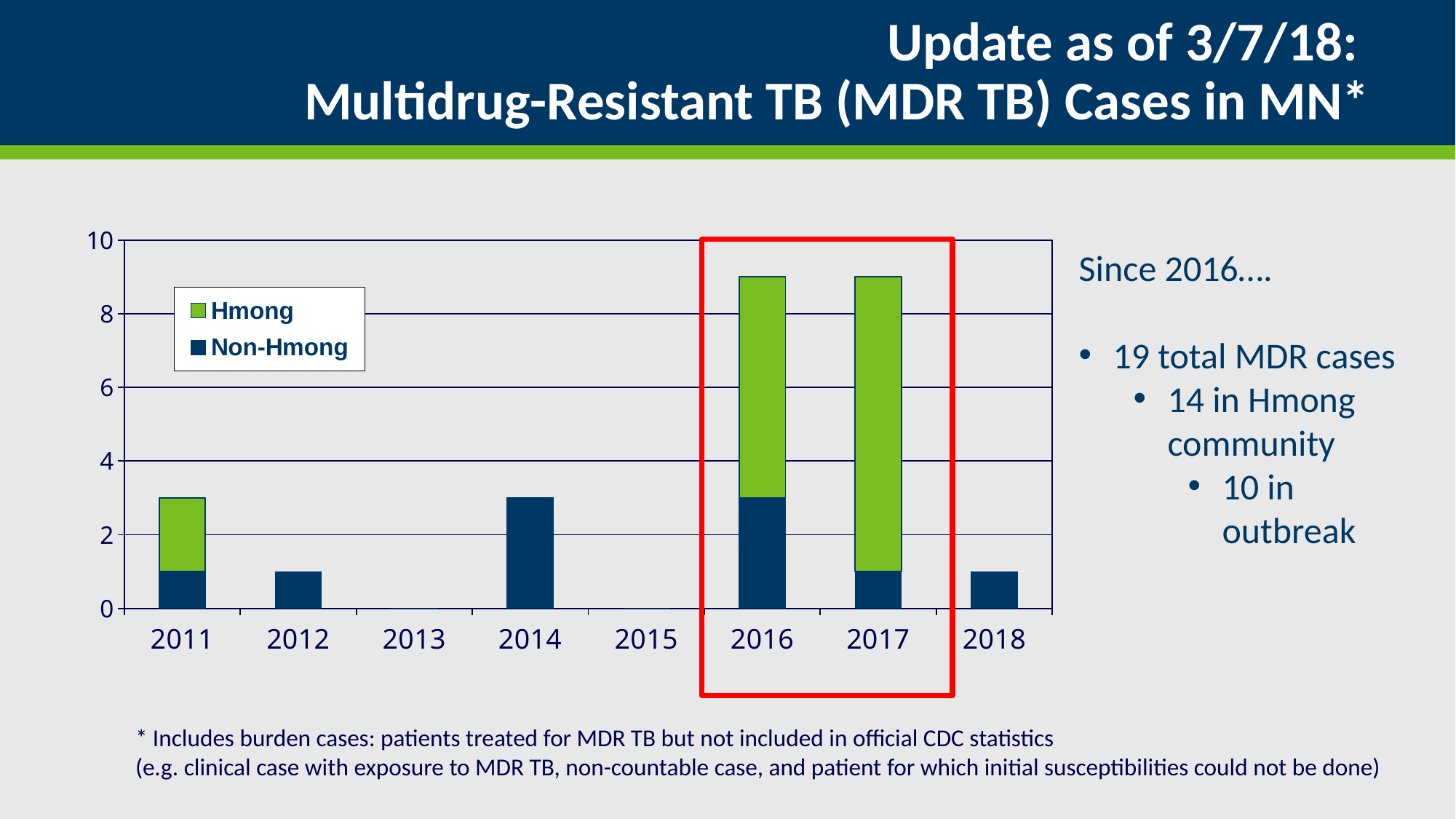
Is the total value for 2016 greater or less than 8? greater Which series is larger in the 2017 bar, Hmong or Non-Hmong? Hmong Is the total value for 2014 greater or less than 4? less How many series does the chart legend list? 2 What is the total number of MDR TB cases shown for 2013? 0 How many years are shown on the x axis of the chart? 8 Which two years are outlined by the red box on the chart? 2016 and 2017 Is the total value for 2012 greater or less than 2? less Which colour represents the Hmong series in the chart? Green What is the total number of MDR TB cases shown for 2015? 0 What kind of chart is shown on the slide? Stacked bar chart Which year has the larger total bar, 2014 or 2017? 2017